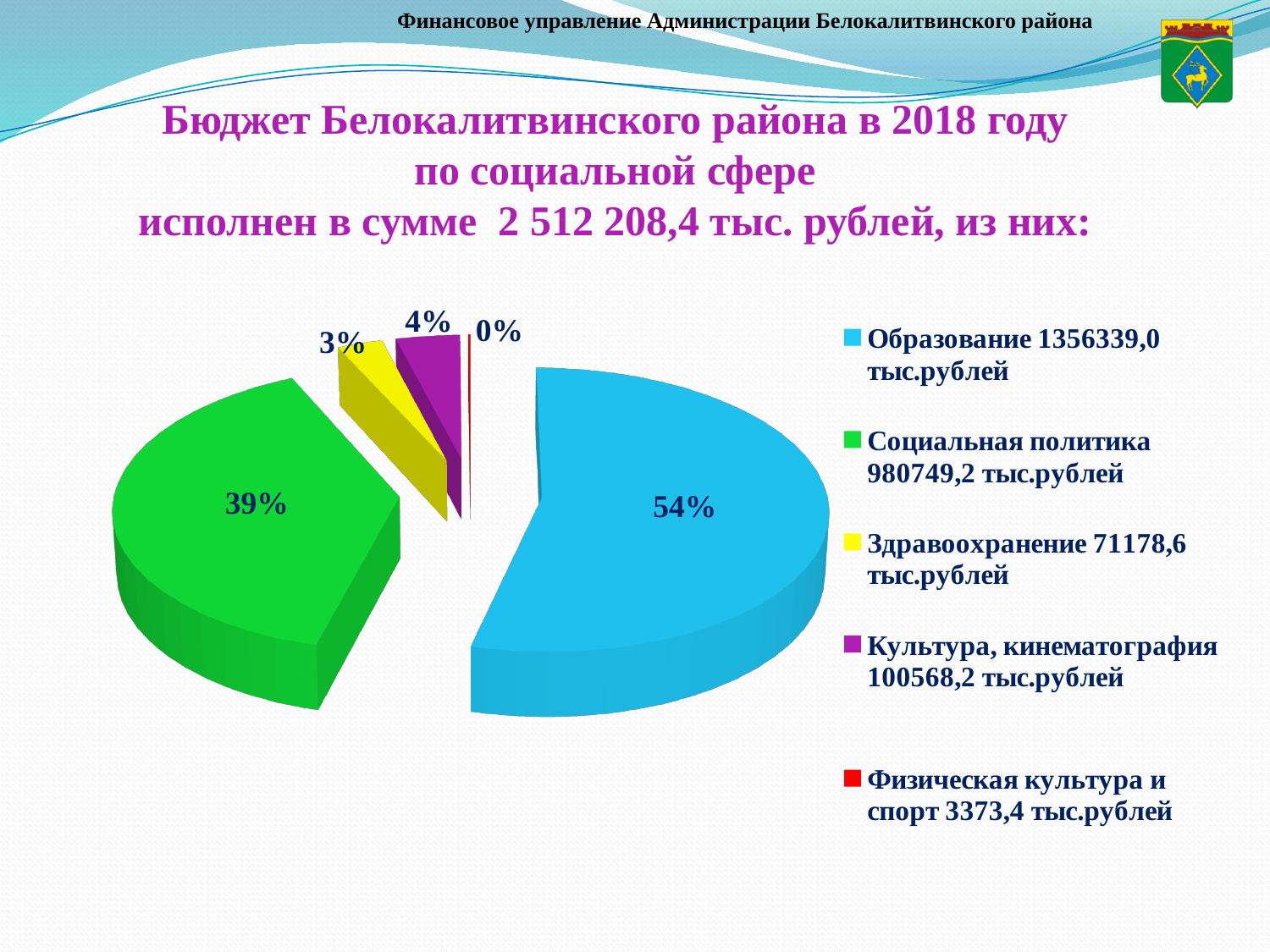
Which slice is larger, Культура, кинематография or Здравоохранение? Культура, кинематография What is the difference in percentage points between the Образование slice and the Социальная политика slice? 15% Which category has the smallest slice of the pie? Физическая культура и спорт How many slices does the pie chart have? 5 What share of the pie does Образование take? 54% Which category has the largest slice of the pie? Образование What kind of chart is shown on the slide? pie chart What share of the pie does Социальная политика take? 39% What share of the pie does Культура, кинематография take? 4% What colour is the Социальная политика slice in the pie chart? green According to the legend, what amount in тыс.рублей is given for Здравоохранение? 71178,6 тыс.рублей